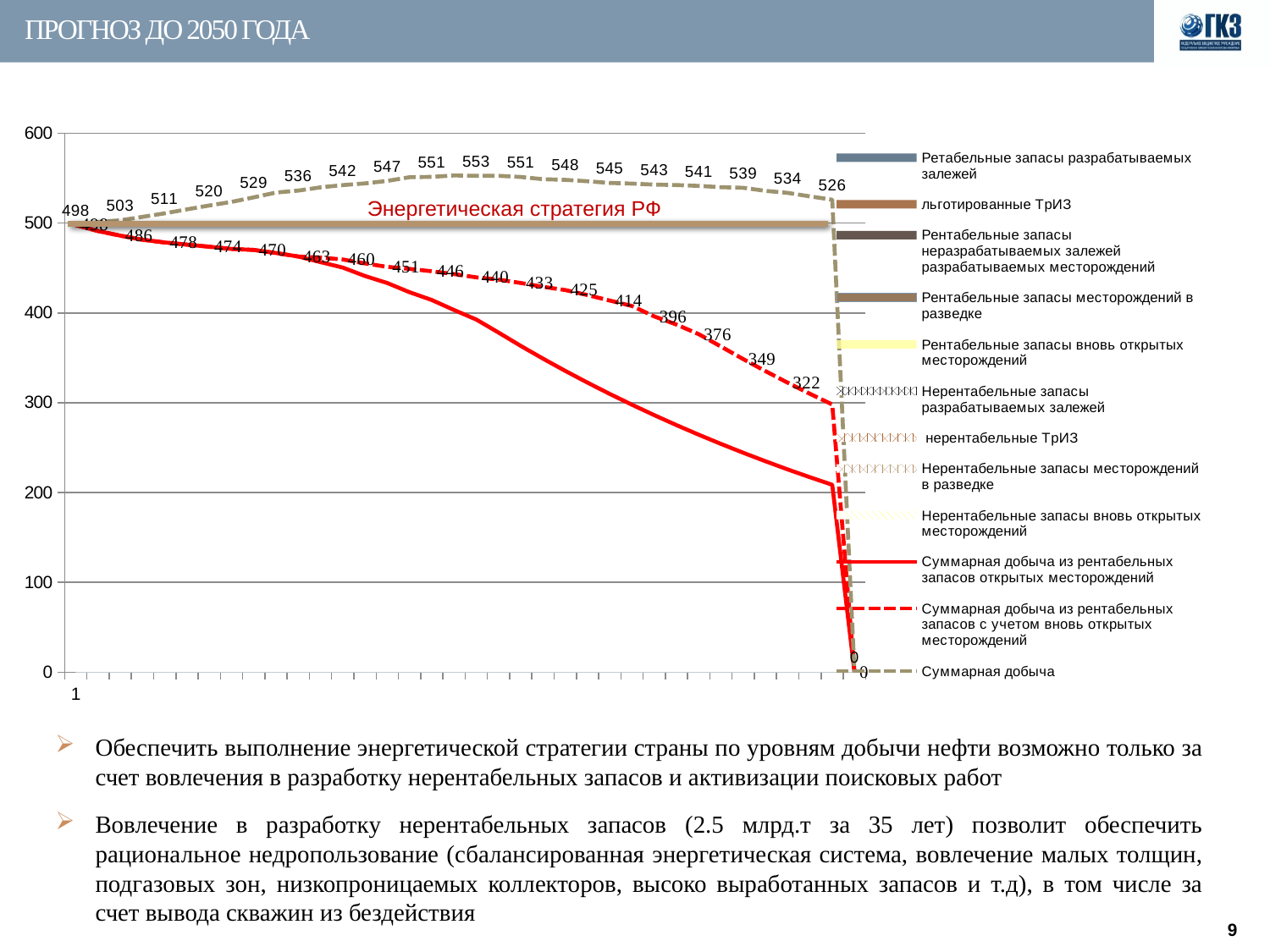
What is the difference between the labelled values 486 and 322 on the red dashed line? 164 Which is larger: the peak of the 'Суммарная добыча' line (553) or the last labelled value of the red dashed line (322)? 553 What is the maximum value shown on the vertical axis? 600 What kind of chart is shown on the slide? line chart What is the highest labelled value on the dashed grey 'Суммарная добыча' line? 553 Is the value of the solid red line just before its final drop to zero greater or less than 300? less Does the red dashed line rise or fall from left to right across the chart? fall What is the first labelled value of the 'Суммарная добыча' line at the left of the chart? 498 How many series does the legend list? 12 What is the last labelled value on the red dashed line before it drops to zero? 322 What text is written above the horizontal line at 500? Энергетическая стратегия РФ What is the difference between the peak value 553 and the last labelled value 526 on the 'Суммарная добыча' line? 27